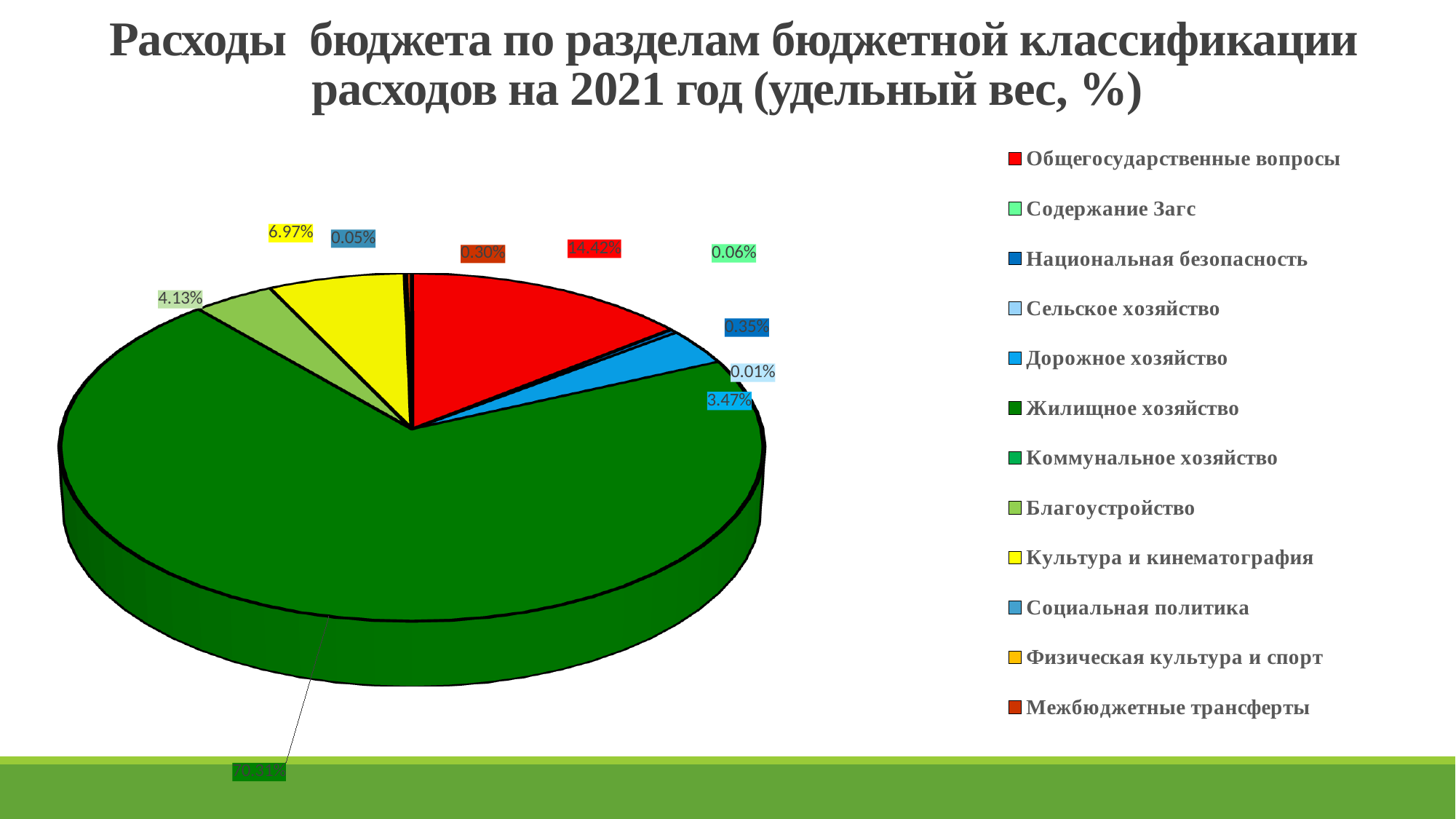
What share is labelled for Культура и кинематография? 6.97% What year does the chart title say the budget expenditure refers to? 2021 Which section has the largest share of the pie? Жилищное хозяйство What share of budget expenditure is labelled for Жилищное хозяйство? 70.31% How many entries does the legend list? 12 What type of chart is shown on the slide? Pie chart What share is labelled for Благоустройство? 4.13% What is the difference between the shares for Общегосударственные вопросы and Культура и кинематография? 7.45% What share is labelled for Межбюджетные трансферты? 0.30% What share is labelled for Общегосударственные вопросы? 14.42% Which is larger, the share for Благоустройство or the share for Дорожное хозяйство? Благоустройство What share is labelled for Дорожное хозяйство? 3.47%